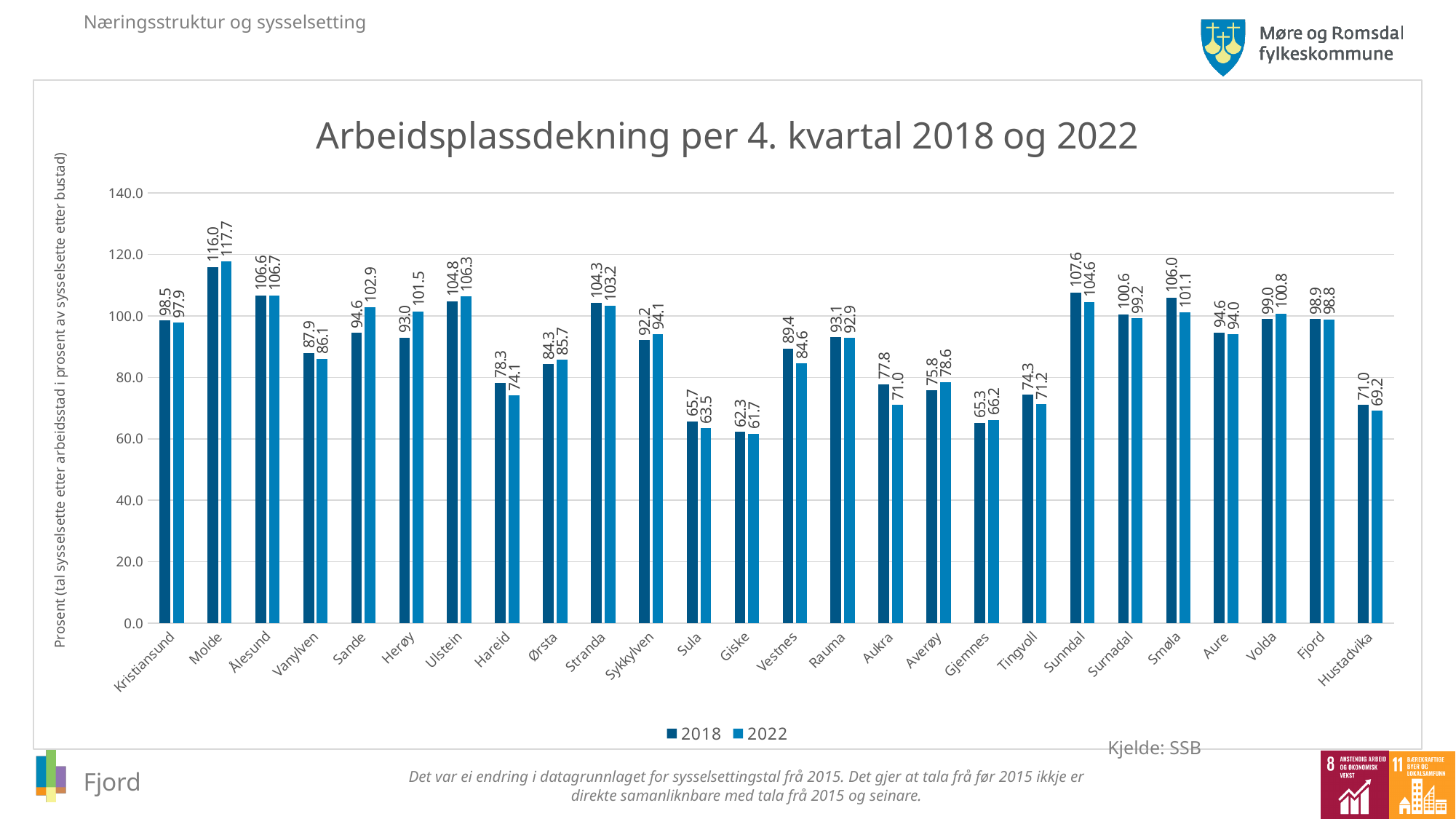
Is the 2018 value for Sunndal greater or less than 100.0? greater Which municipality has the highest value in 2022? Molde Which is larger for Herøy: the 2018 value or the 2022 value? 2022 What kind of chart is shown on the slide? Bar chart What is the difference between the 2018 and 2022 values for Aukra? 6.8 What is the value for Sande in 2018? 94.6 Which municipality has the lowest value in 2018? Giske What is the difference between the 2022 and 2018 values for Sande? 8.3 How many series does the legend list? 2 What is the value for Hustadvika in 2022? 69.2 How many municipalities are shown on the x axis? 26 What is the value for Molde in 2022? 117.7